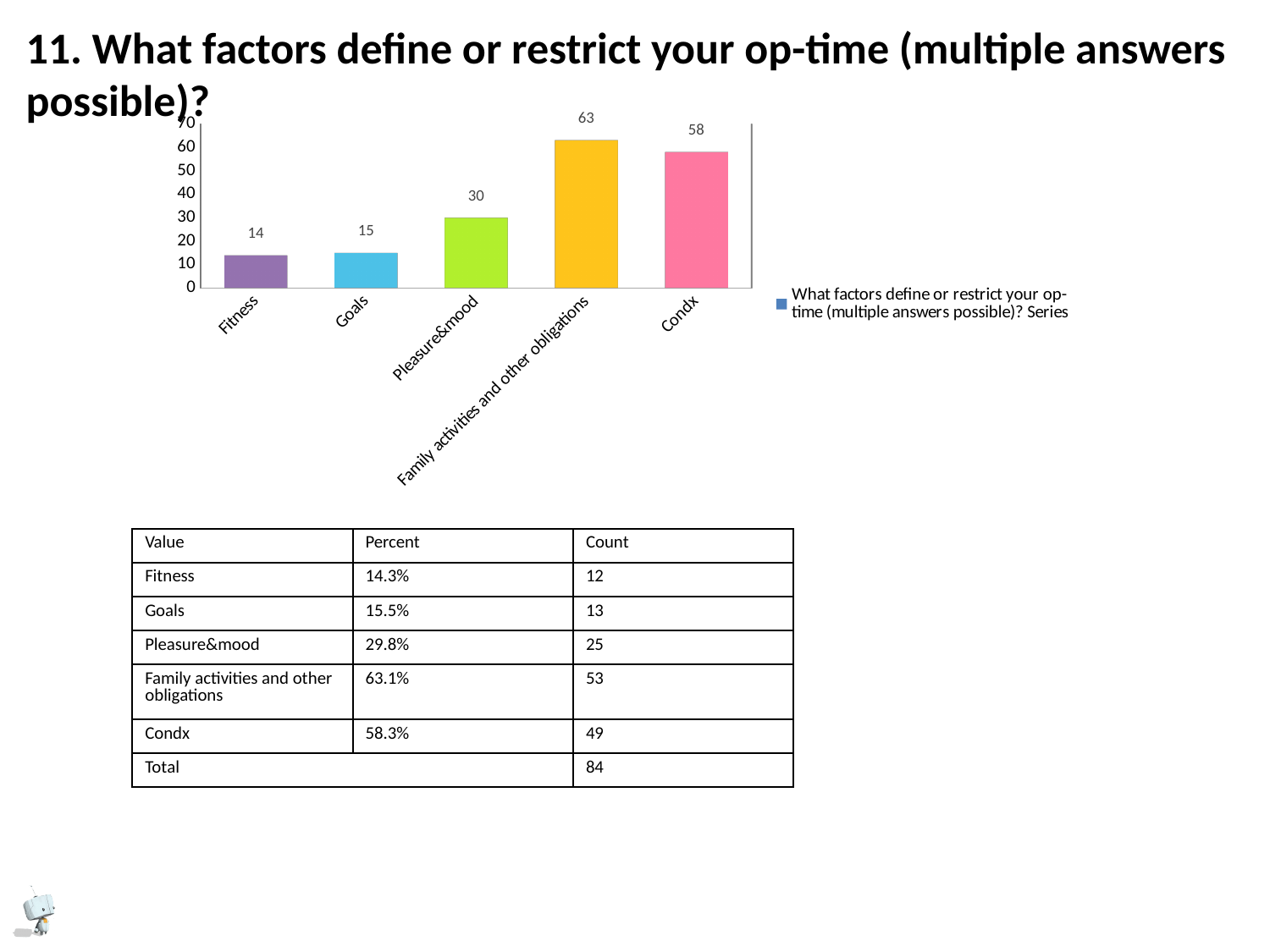
What value does the chart show for Fitness? 14 What value does the chart show for Condx? 58 Which category has the lowest value in the chart? Fitness What is the difference between the values for Pleasure&mood and Goals? 15 Which is larger, the value for Goals or the value for Pleasure&mood? Pleasure&mood What value does the chart show for Pleasure&mood? 30 What kind of chart is shown on the slide? bar chart Is the value for Condx greater or less than 50? greater How many categories are shown on the x axis of the chart? 5 Which category has the highest value in the chart? Family activities and other obligations What is the difference between the values for Family activities and other obligations and Condx? 5 What is the highest value shown on the chart's y axis? 70